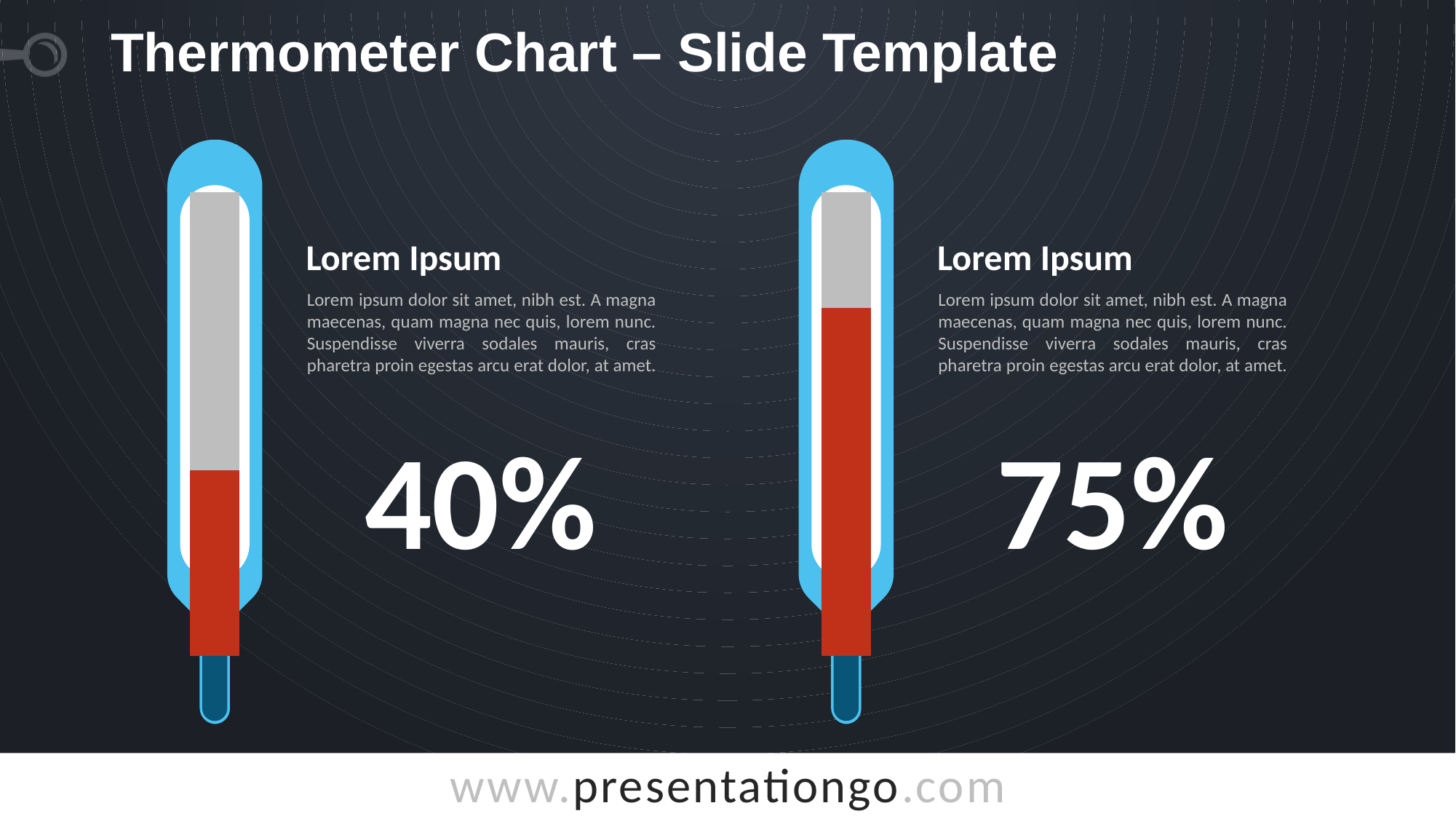
What colour is the fill inside the thermometers that indicates the value? red What value is shown for the right thermometer chart? 75% What value is shown for the left thermometer chart? 40% How many thermometer charts are shown on the slide? 2 What is the difference between the right thermometer's value and the left thermometer's value? 35% What kind of chart is used on this slide? thermometer chart What is the title of the slide? Thermometer Chart – Slide Template Which thermometer shows the highest value? the right one (75%) Which thermometer shows the lowest value? the left one (40%) Which thermometer shows the higher value, the left or the right one? the right one